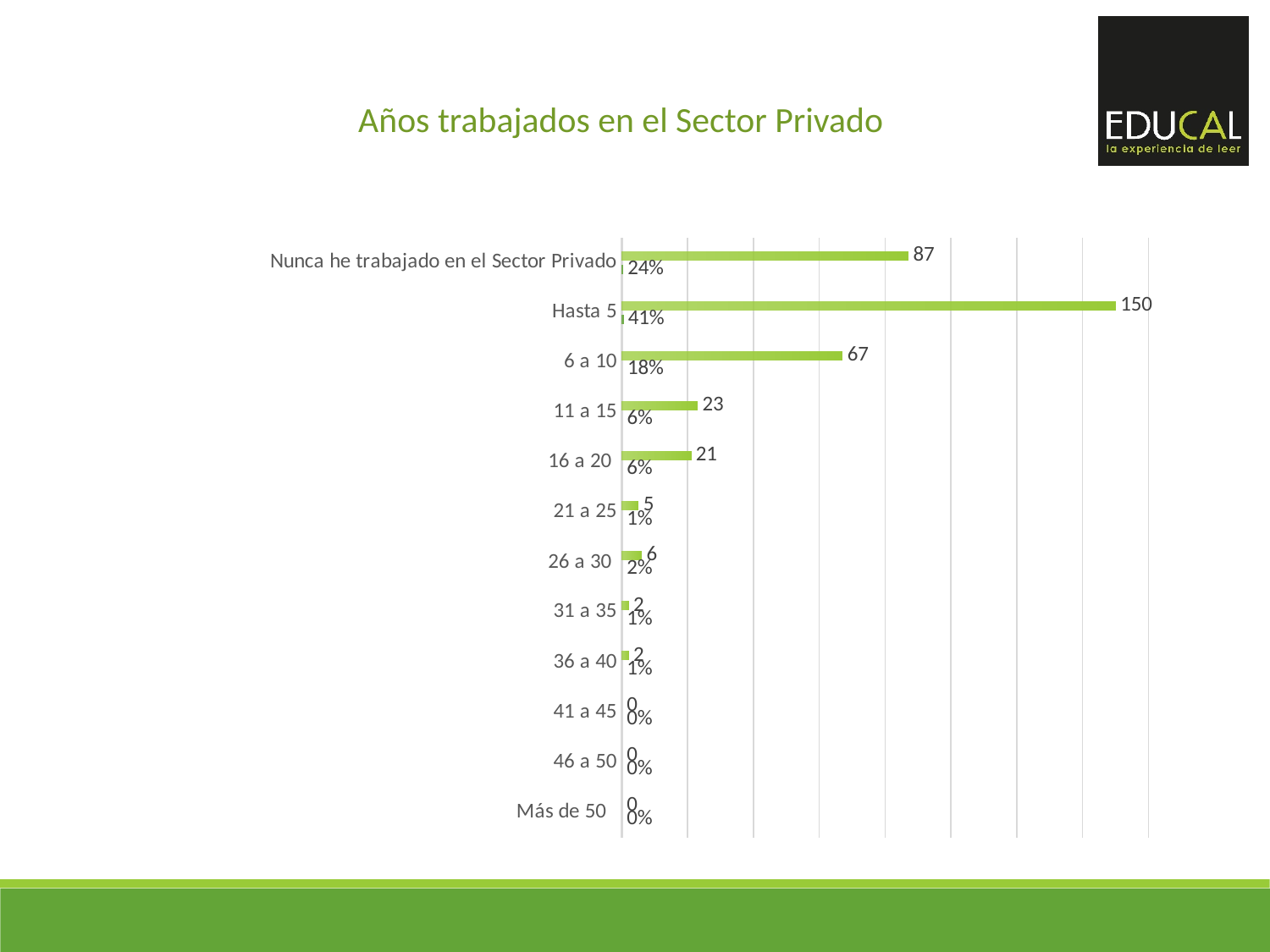
What is the count value for 'Más de 50'? 0 What kind of chart is shown on the slide? Bar chart What percentage is shown for 'Nunca he trabajado en el Sector Privado'? 24% What is the difference between the counts for '11 a 15' and '16 a 20'? 2 What is the count value for '6 a 10'? 67 What is the difference between the counts for 'Hasta 5' and 'Nunca he trabajado en el Sector Privado'? 63 What is the title of the chart? Años trabajados en el Sector Privado What is the count value for 'Hasta 5'? 150 Which category has the highest count? Hasta 5 What percentage is shown for '16 a 20'? 6% How many categories are shown on the chart? 12 Which has a larger count, '21 a 25' or '26 a 30'? 26 a 30